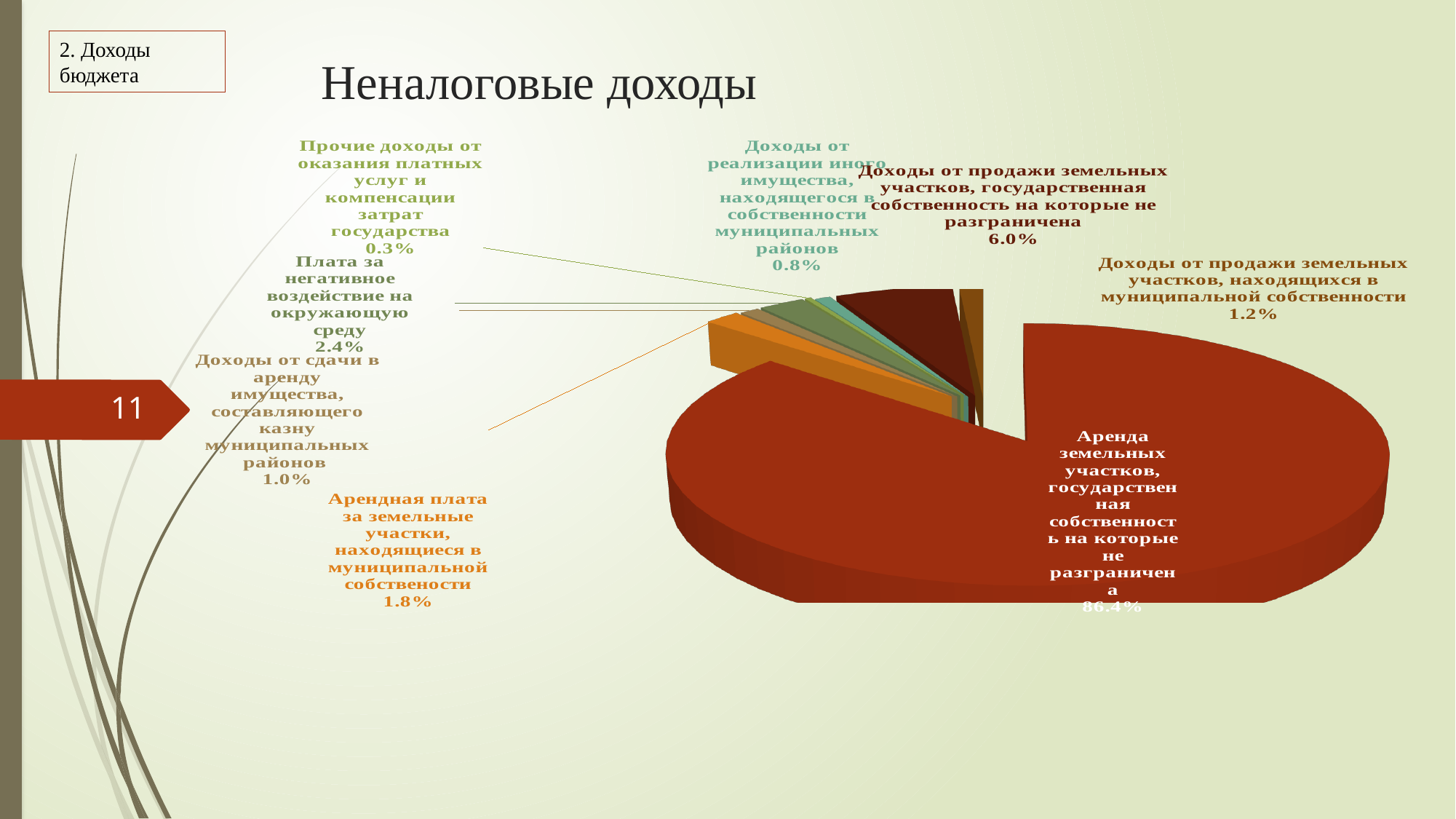
What share is shown for 'Плата за негативное воздействие на окружающую среду'? 2.4% Which is larger: the share for 'Доходы от продажи земельных участков, находящихся в муниципальной собственности' or the share for 'Доходы от сдачи в аренду имущества, составляющего казну муниципальных районов'? Доходы от продажи земельных участков, находящихся в муниципальной собственности What is the difference in percentage points between the share for 'Доходы от продажи земельных участков, государственная собственность на которые не разграничена' (6.0%) and the share for 'Плата за негативное воздействие на окружающую среду' (2.4%)? 3.6 What share of the pie is labelled 'Аренда земельных участков, государственная собственность на которые не разграничена'? 86.4% Which category has the largest share of the pie? Аренда земельных участков, государственная собственность на которые не разграничена What share is shown for 'Доходы от реализации иного имущества, находящегося в собственности муниципальных районов'? 0.8% What share is shown for 'Арендная плата за земельные участки, находящиеся в муниципальной собствености'? 1.8% What is the title of the chart on the slide? Неналоговые доходы How many slices does the pie chart have? 8 Which category has the smallest share of the pie? Прочие доходы от оказания платных услуг и компенсации затрат государства What kind of chart is shown on the slide? pie chart What share is shown for 'Доходы от продажи земельных участков, государственная собственность на которые не разграничена'? 6.0%